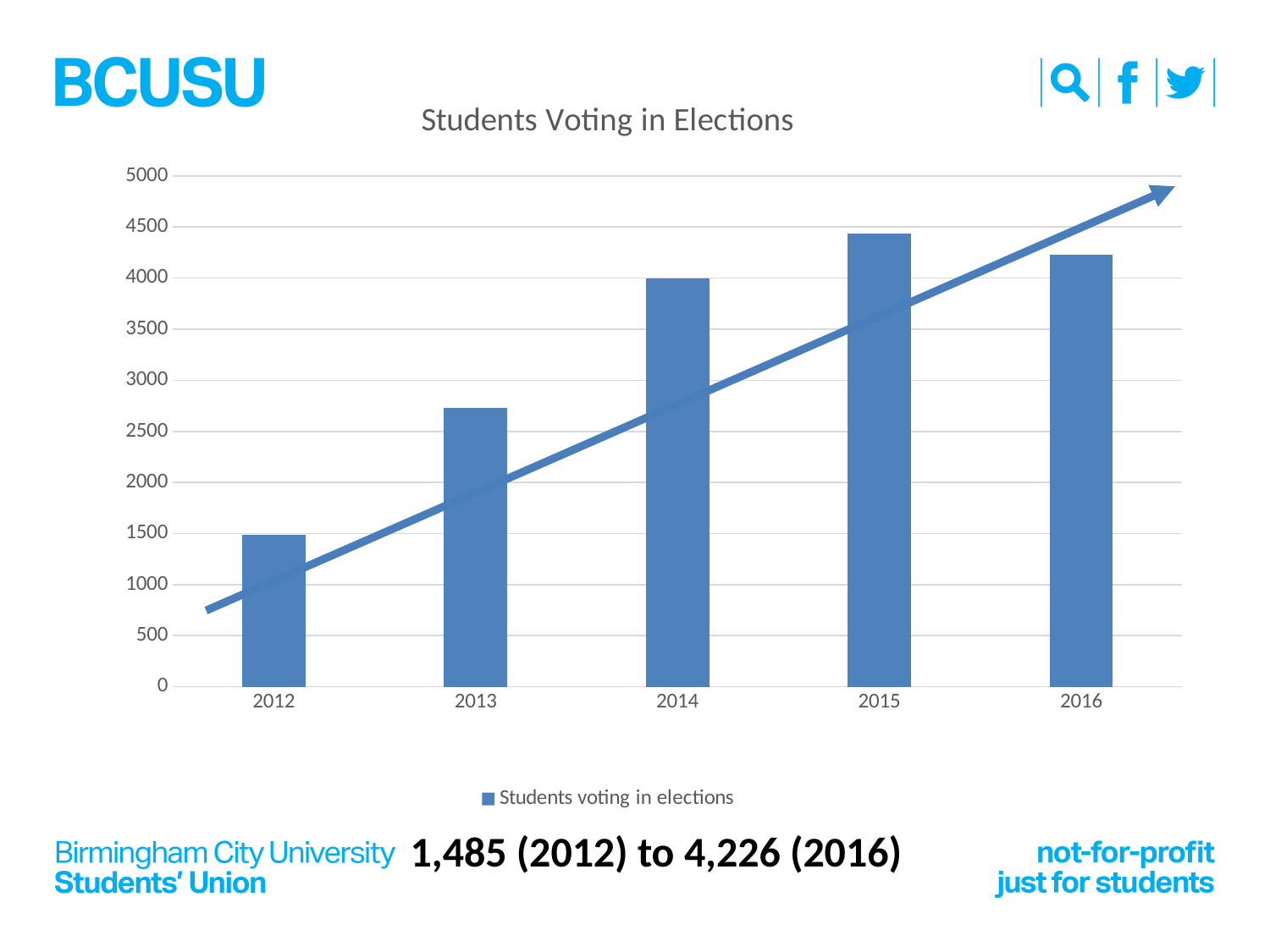
Which year has the lowest number of students voting in elections? 2012 What is the title of the chart? Students Voting in Elections By how much did the number of students voting increase from 2012 to 2016? 2,741 What kind of chart is shown on the slide? bar chart Is the value for 2013 greater or less than 3000? less What is the legend entry for the series in the chart? Students voting in elections Which year has the highest number of students voting in elections? 2015 How many students voted in elections in 2012, according to the slide? 1,485 How many years are shown on the x axis of the chart? 5 How many students voted in elections in 2016, according to the slide? 4,226 Is the value for 2014 greater or less than 3500? greater How many series does the chart's legend list? 1